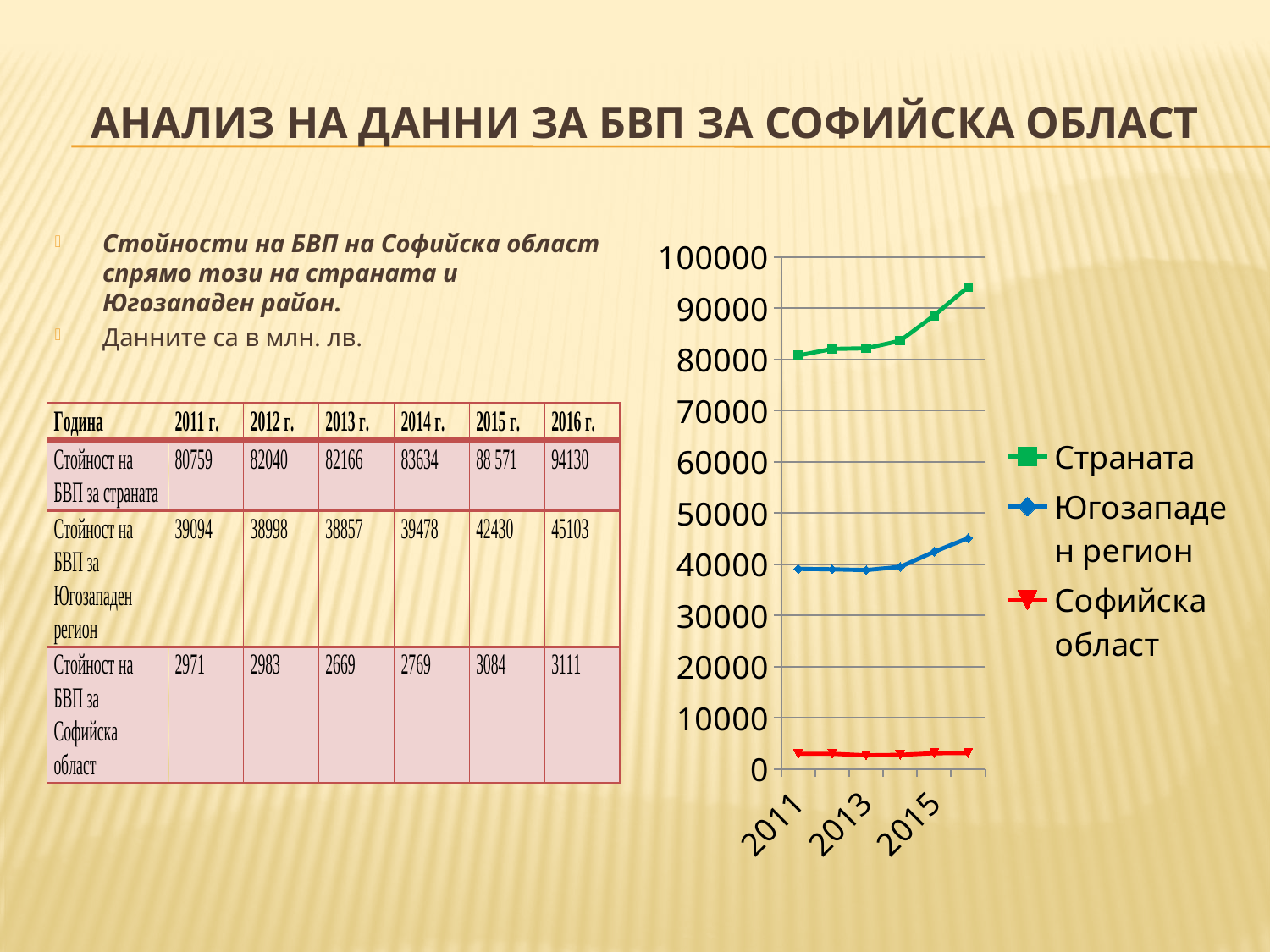
What is the value for Страната in 2016 according to the table on the slide? 94130 Is the value for Югозападен регион in 2011 greater or less than 40000? less Is the value for Страната in 2016 greater or less than 90000? greater Which series has the highest values in the chart? Страната Is the value for Софийска област in 2015 greater or less than 10000? less Which series has the lowest values in the chart? Софийска област How many series does the chart legend list? 3 What kind of chart is shown on the slide? line chart Do the values for Страната rise or fall from 2011 to 2016? rise Which is larger in 2014: the value for Югозападен регион or the value for Софийска област? Югозападен регион What is the value for Югозападен регион in 2015 according to the table on the slide? 42430 What is the value for Софийска област in 2013 according to the table on the slide? 2669